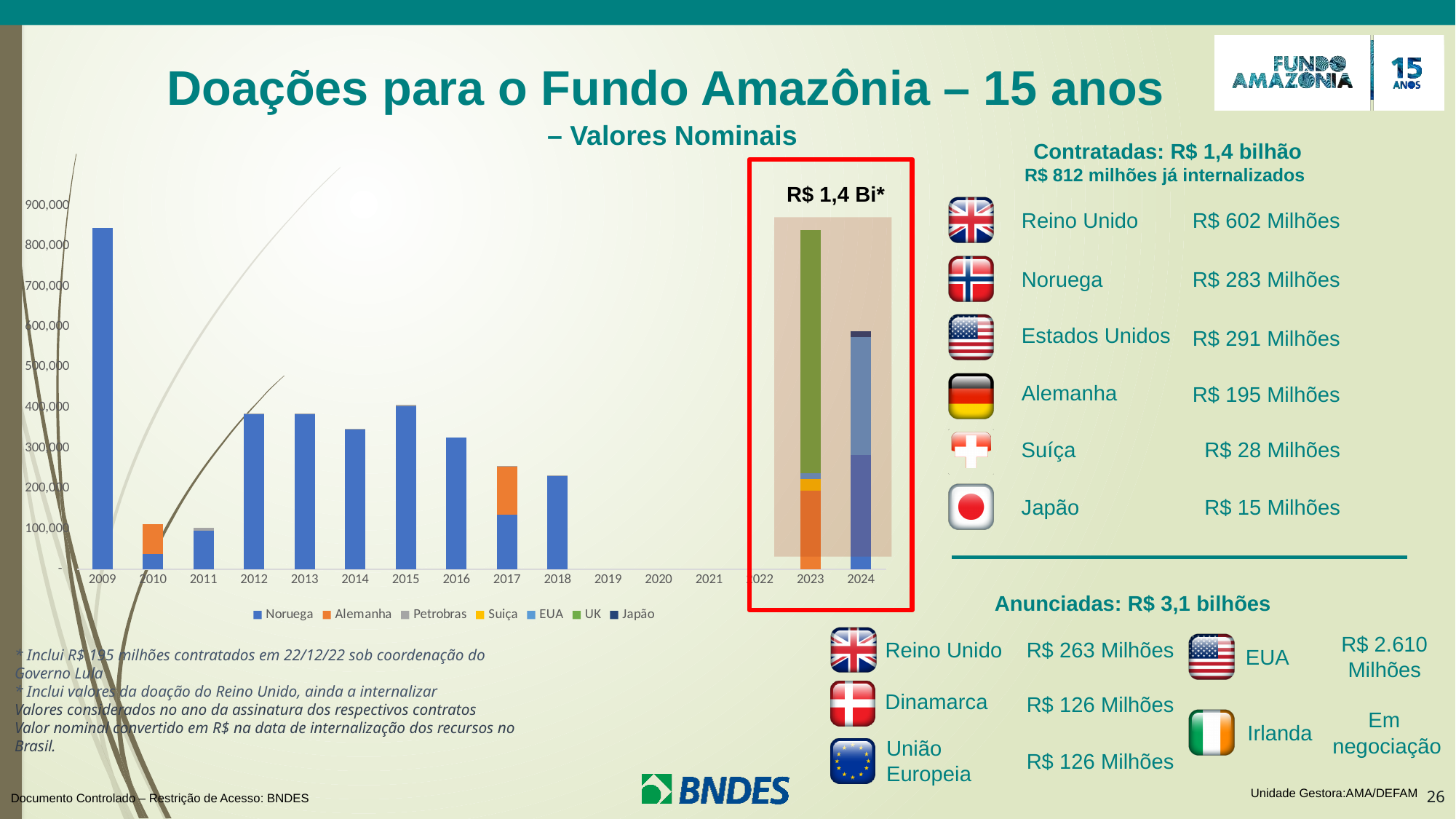
What label is printed above the highlighted 2023–2024 bars? R$ 1,4 Bi* Do the bar values rise or fall from 2015 to 2018? fall Is the value for 2018 greater or less than 200,000? greater Which bar is taller, 2023 or 2024? 2023 Is the value for 2014 greater or less than 400,000? less Is the value for 2009 greater or less than 800,000? greater Which bar is taller, 2013 or 2018? 2013 Which series is shown in green in the chart legend? UK How many years are shown on the x axis of the chart? 16 How many series does the chart legend list? 7 Which year has the tallest bar in the chart? 2009 What kind of chart is shown on the slide? bar chart